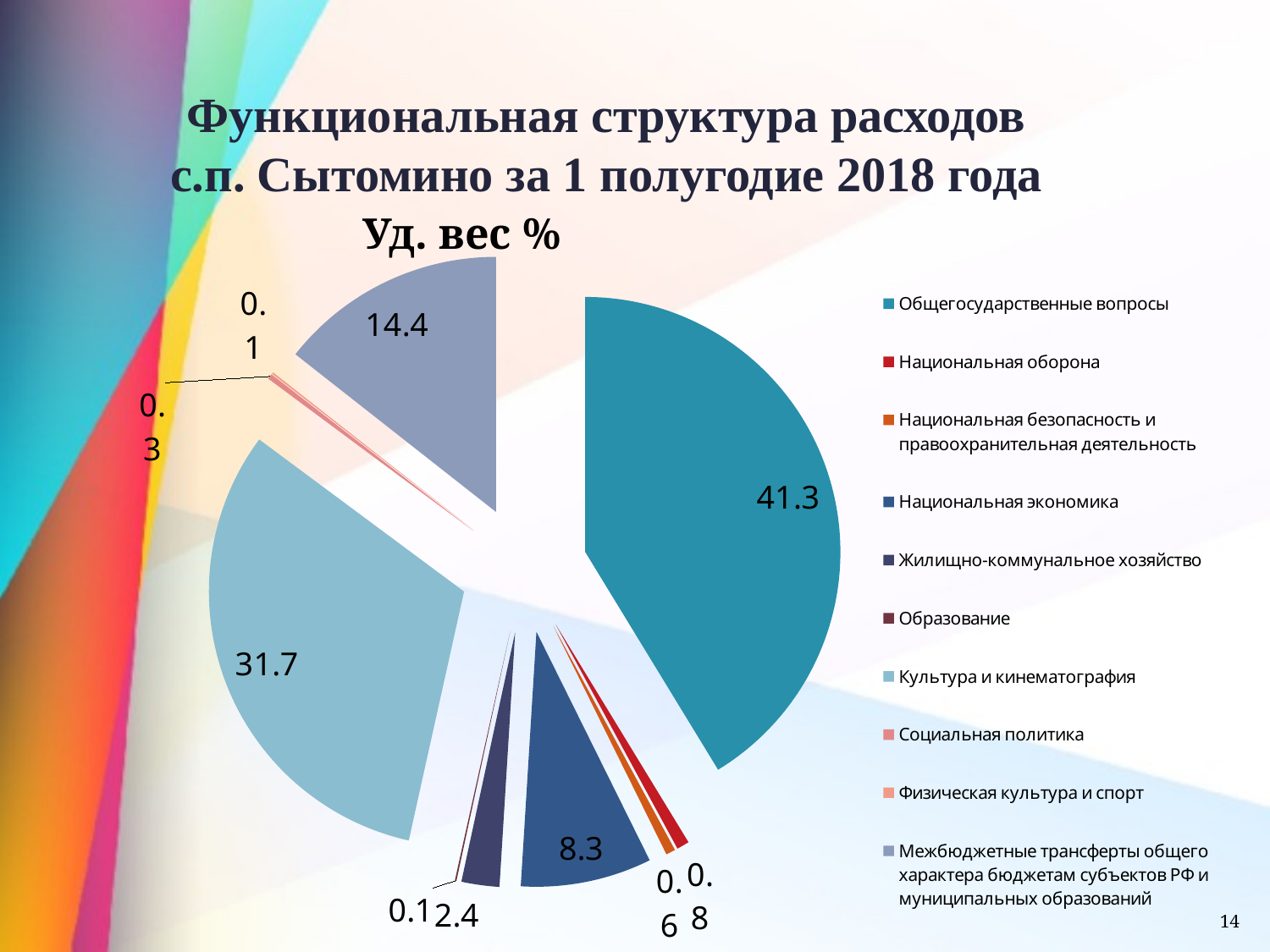
What is the title of the chart? Уд. вес % What is the difference between the values for Общегосударственные вопросы and Культура и кинематография? 9.6 What is the value for Жилищно-коммунальное хозяйство? 2.4 What is the value for Общегосударственные вопросы? 41.3 What kind of chart is shown on the slide? pie chart What is the value for Национальная экономика? 8.3 What is the difference between the values for Культура и кинематография and Межбюджетные трансферты общего характера бюджетам субъектов РФ и муниципальных образований? 17.3 Which category has the largest slice of the pie? Общегосударственные вопросы What is the value for Межбюджетные трансферты общего характера бюджетам субъектов РФ и муниципальных образований? 14.4 Which is larger, the value for Национальная экономика or the value for Жилищно-коммунальное хозяйство? Национальная экономика What is the value for Культура и кинематография? 31.7 How many categories does the legend list? 10